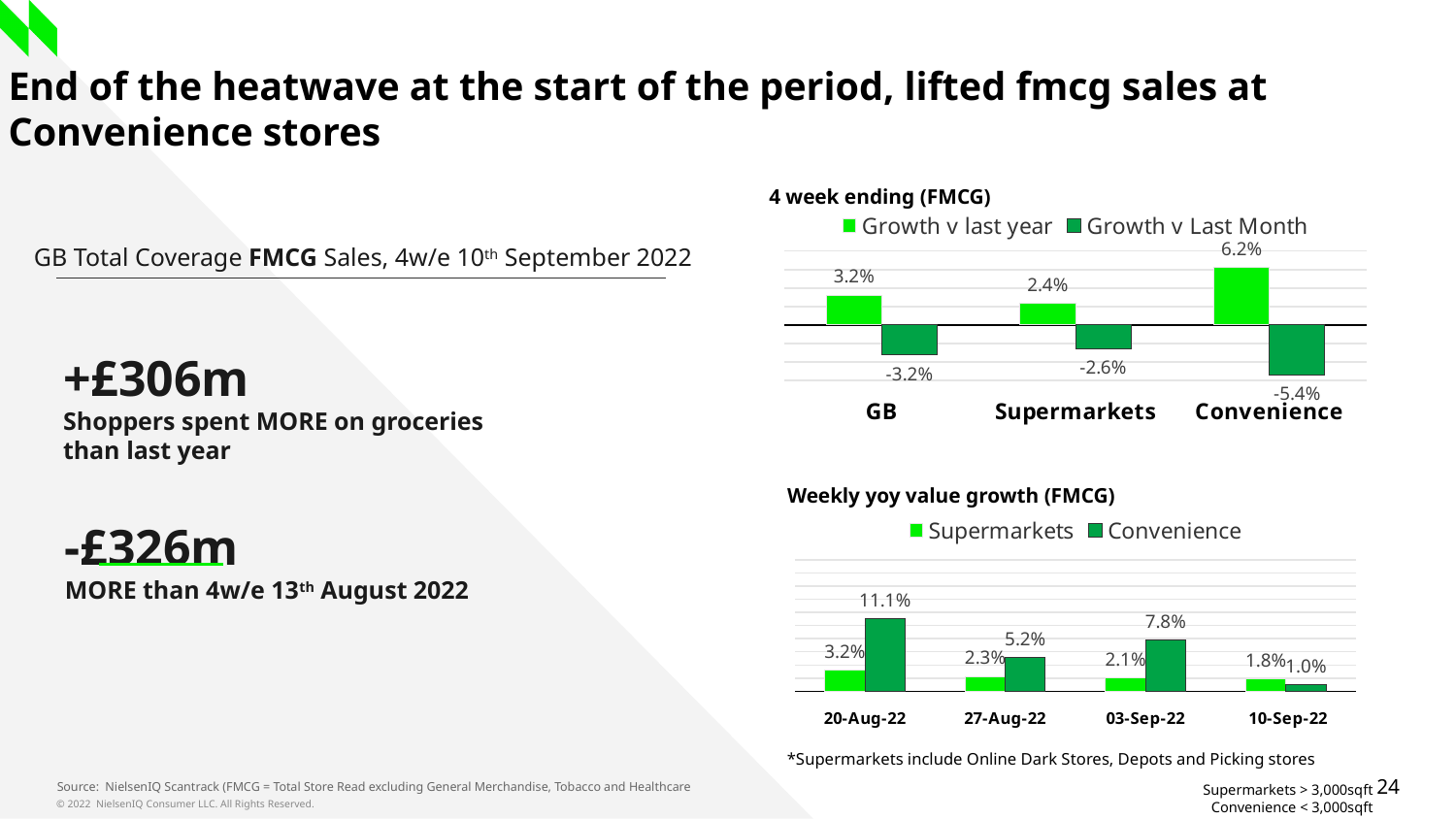
In the 'Weekly yoy value growth (FMCG)' chart, what is the Convenience value for 03-Sep-22? 7.8% In the 'Weekly yoy value growth (FMCG)' chart, do the Supermarkets values rise or fall from 20-Aug-22 to 10-Sep-22? fall In the 'Weekly yoy value growth (FMCG)' chart, what is the Supermarkets value for 27-Aug-22? 2.3% In the '4 week ending (FMCG)' chart, which category has the highest Growth v last year? Convenience What kind of chart is the 'Weekly yoy value growth (FMCG)' chart? bar chart In the 'Weekly yoy value growth (FMCG)' chart, how many weeks are shown on the x axis? 4 How many series does the legend of the '4 week ending (FMCG)' chart list? 2 In the '4 week ending (FMCG)' chart, which category has the lowest Growth v Last Month? Convenience In the '4 week ending (FMCG)' chart, what is the Growth v Last Month value for Supermarkets? -2.6% In the '4 week ending (FMCG)' chart, what is the difference between the Growth v last year values for Convenience and GB? 3.0% In the '4 week ending (FMCG)' chart, what is the Growth v last year value for Convenience? 6.2% In the 'Weekly yoy value growth (FMCG)' chart, which week has the highest Convenience value? 20-Aug-22